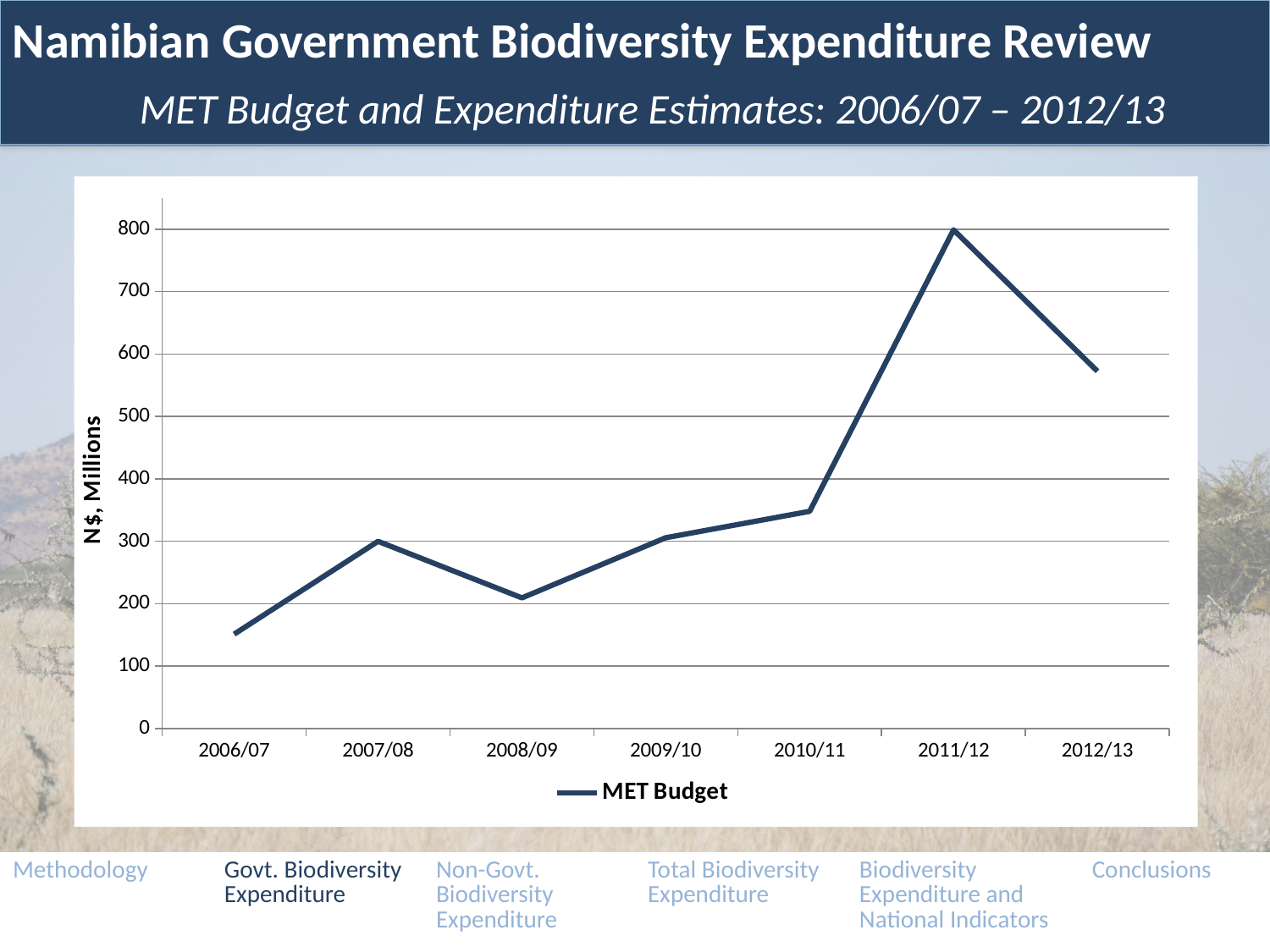
How many series does the legend list? 1 Is the MET Budget for 2008/09 greater or less than 300? less Is the MET Budget for 2012/13 greater or less than 500? greater Which year has a larger MET Budget, 2007/08 or 2008/09? 2007/08 In which year is the MET Budget lowest? 2006/07 Does the MET Budget rise or fall from 2011/12 to 2012/13? fall What kind of chart is shown on the slide? line chart How many fiscal years are plotted on the x axis? 7 Is the MET Budget for 2011/12 greater or less than 700? greater What is the label on the vertical axis? N$, Millions In which year is the MET Budget highest? 2011/12